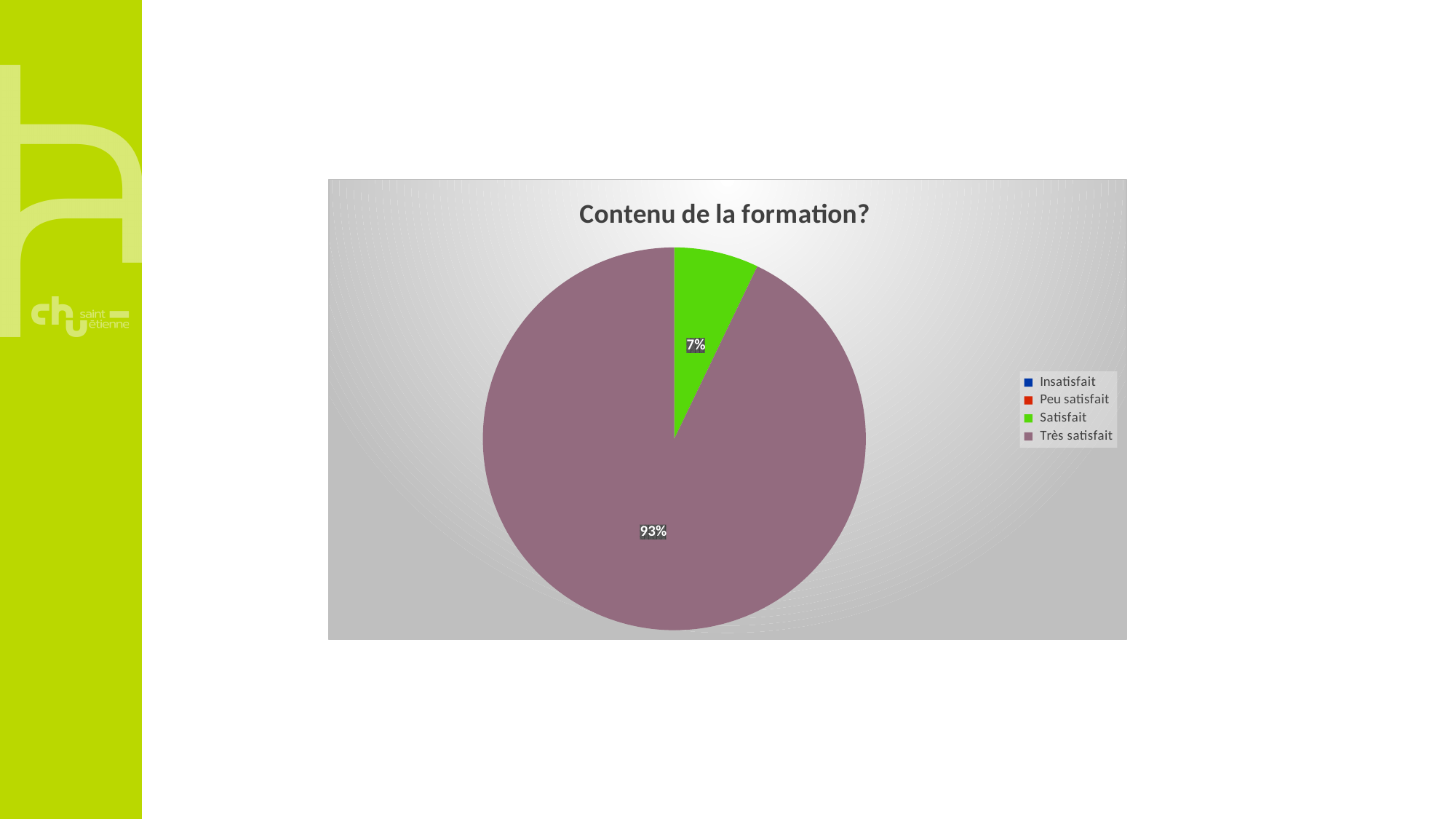
What kind of chart is shown on the slide? pie chart How many categories does the legend list? 4 What is the difference between the Très satisfait and Satisfait shares? 86% What share of the pie does Très satisfait represent? 93% Which is larger, the Satisfait slice or the Très satisfait slice? Très satisfait Which category has the largest slice of the pie? Très satisfait What share of the pie does Satisfait represent? 7% What is the title of the chart? Contenu de la formation? What colour is the Satisfait slice? green Is the share for Très satisfait greater or less than 50%? greater